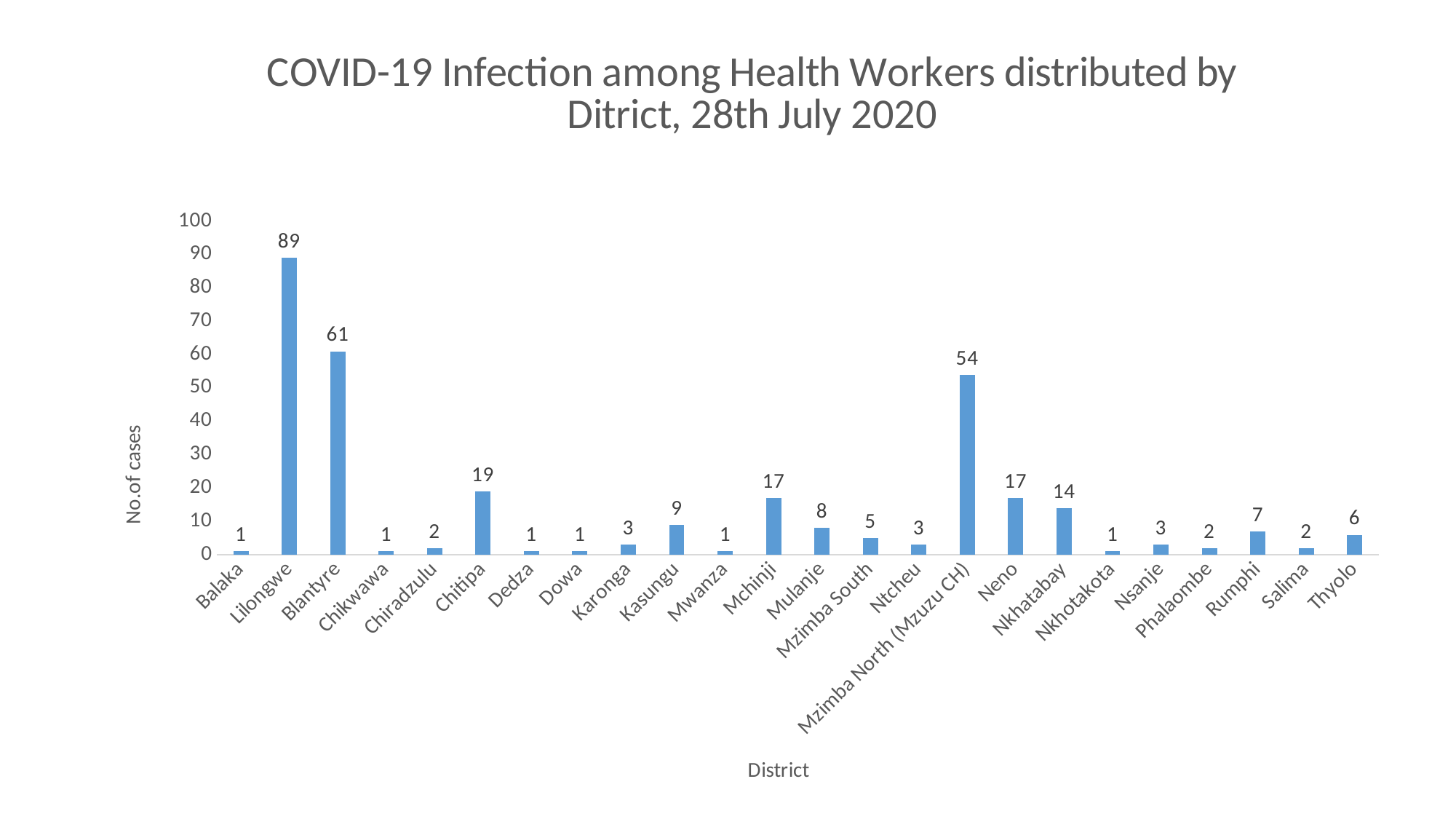
Which district has the highest number of cases? Lilongwe What is the number of cases for Lilongwe? 89 What is the number of cases for Mzimba North (Mzuzu CH)? 54 What is the number of cases for Nkhatabay? 14 Which has more cases, Mulanje or Rumphi? Mulanje What kind of chart is shown on the slide? Bar chart What is the difference in cases between Mzimba North (Mzuzu CH) and Chitipa? 35 How many districts are shown on the x axis? 24 What is the difference in cases between Lilongwe and Blantyre? 28 Which has more cases, Blantyre or Mzimba North (Mzuzu CH)? Blantyre What is the label of the y axis? No.of cases What is the number of cases for Kasungu? 9